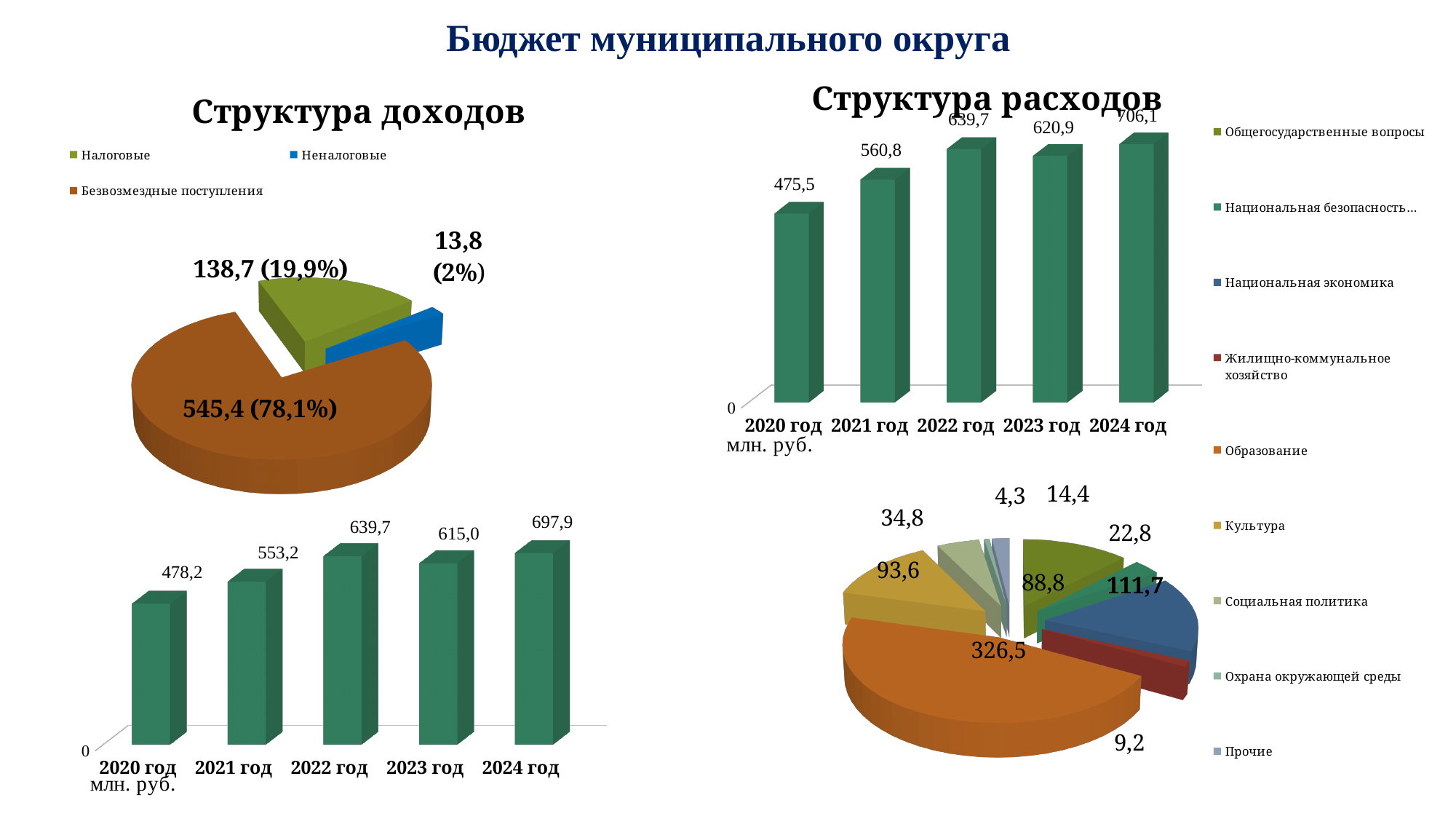
How many series does the legend of the 'Структура доходов' pie chart list? 3 In the 'Структура расходов' bar chart, what is the value for 2020 год? 475,5 In the bar chart at the bottom left of the slide (income by year), what is the value for 2021 год? 553,2 In the 'Структура доходов' pie chart, which category has the smallest slice? Неналоговые What type of chart is used at the bottom right of the slide to show the breakdown of expenditures? Pie chart In the bar chart at the bottom left of the slide (income by year), what is the difference between the values for 2022 год and 2023 год? 24,7 In the 'Структура доходов' pie chart, what share of the pie does Налоговые take? 19,9% In the 'Структура расходов' bar chart, which is larger: the value for 2022 год or 2023 год? 2022 год In the expenditure pie chart at the bottom right of the slide, what is the value of the largest slice? 326,5 How many years (categories) are shown in the 'Структура расходов' bar chart? 5 In the 'Структура доходов' pie chart, what is the value shown for Безвозмездные поступления? 545,4 (78,1%) In the bar chart at the bottom left of the slide (income by year), which year has the highest value? 2024 год